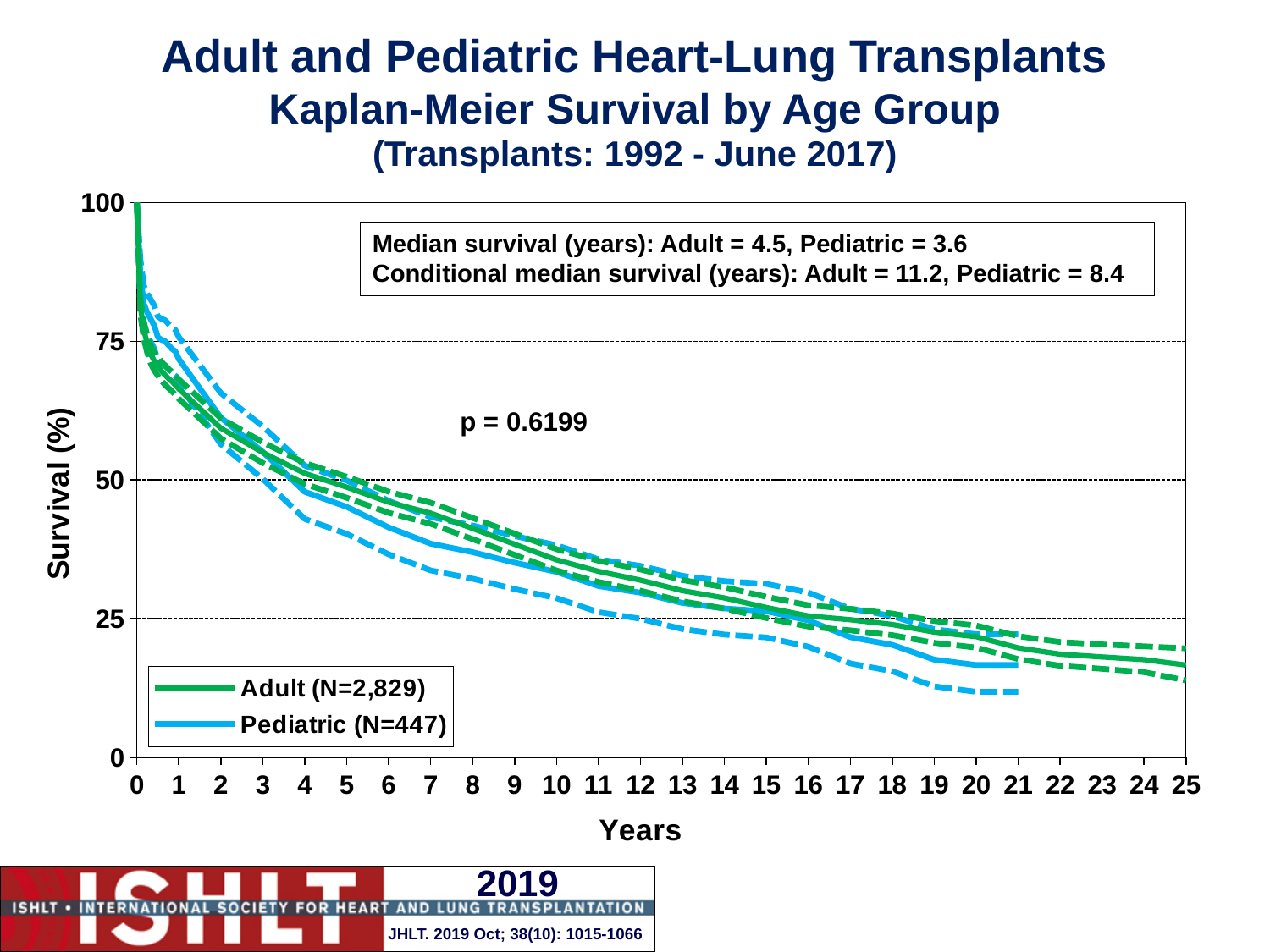
What is the median survival in years for the Pediatric group? 3.6 What is the difference in conditional median survival (years) between the Adult and Pediatric groups? 2.8 How many series does the legend list? 2 What is the conditional median survival in years for the Pediatric group? 8.4 What is the median survival in years for the Adult group? 4.5 What type of chart is shown on the slide? Line chart What is the p-value shown on the chart? p = 0.6199 What is the N for the Pediatric group in the legend? 447 What is the conditional median survival in years for the Adult group? 11.2 Is the Adult survival at 10 years greater or less than 50%? less Which group has the higher median survival, Adult or Pediatric? Adult Do the survival curves rise or fall as years increase? Fall